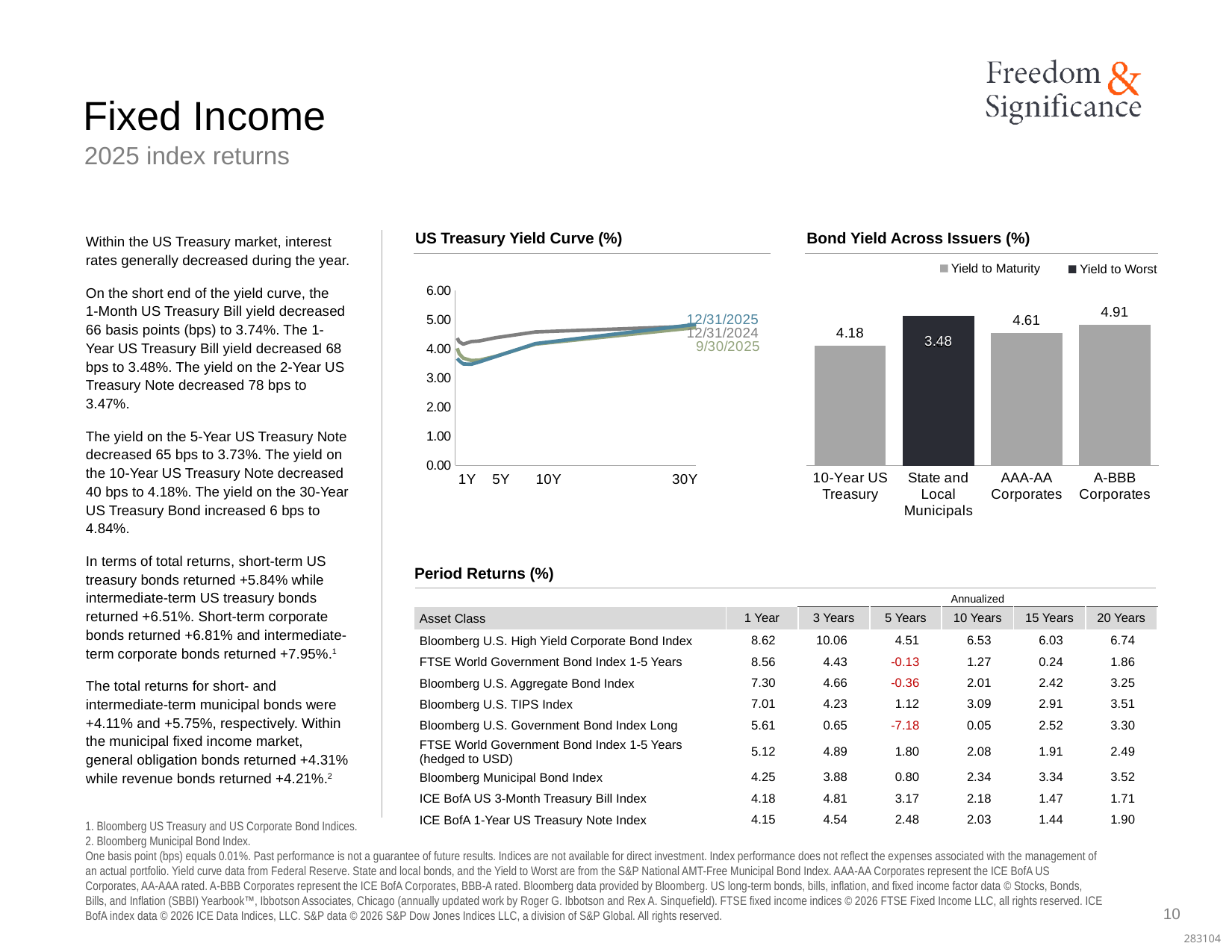
In the US Treasury Yield Curve (%) chart, do the yields generally rise or fall from 1Y to 30Y? Rise In the Bond Yield Across Issuers (%) chart, what is the value for A-BBB Corporates? 4.91 In the Bond Yield Across Issuers (%) chart, what is the value for 10-Year US Treasury? 4.18 In the Bond Yield Across Issuers (%) chart, what is the difference between A-BBB Corporates and AAA-AA Corporates? 0.30 What kind of chart is the US Treasury Yield Curve (%) chart? Line chart In the Bond Yield Across Issuers (%) chart, which category has the lowest value? State and Local Municipals In the Bond Yield Across Issuers (%) chart, what is the value for State and Local Municipals? 3.48 In the Bond Yield Across Issuers (%) chart, which is larger, 10-Year US Treasury or AAA-AA Corporates? AAA-AA Corporates In the Bond Yield Across Issuers (%) chart, which category has the highest value? A-BBB Corporates How many categories are shown in the Bond Yield Across Issuers (%) chart? 4 In the US Treasury Yield Curve (%) chart, is the 12/31/2025 value at 1Y greater or less than 4.00? less How many series does the legend of the Bond Yield Across Issuers (%) chart list? 2